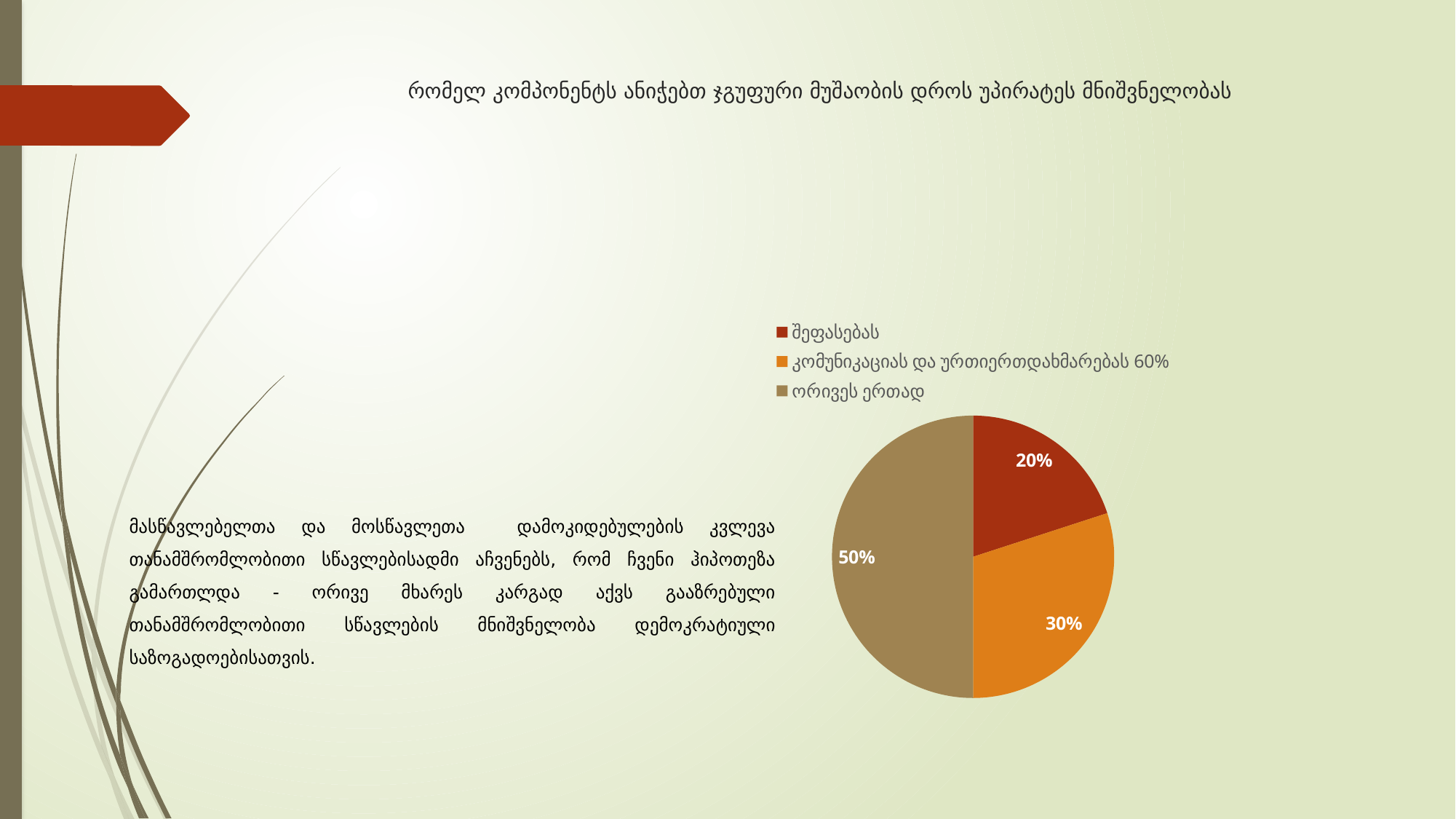
What is the value for შეფასებას in the pie chart? 20% What colour is the slice for შეფასებას in the pie chart? dark red Which is larger: the slice for შეფასებას or the slice for კომუნიკაციას და ურთიერთდახმარებას 60%? კომუნიკაციას და ურთიერთდახმარებას 60% How many slices does the pie chart have? 3 What is the value for ორივეს ერთად in the pie chart? 50% Which category has the largest slice in the pie chart? ორივეს ერთად What share of the pie does the ორივეს ერთად slice represent? 50% What is the difference between the ორივეს ერთად slice and the შეფასებას slice? 30% Which category has the smallest slice in the pie chart? შეფასებას How many entries does the legend of the pie chart list? 3 What kind of chart is shown on the slide? pie chart What is the value for the slice labelled კომუნიკაციას და ურთიერთდახმარებას 60% in the pie chart? 30%